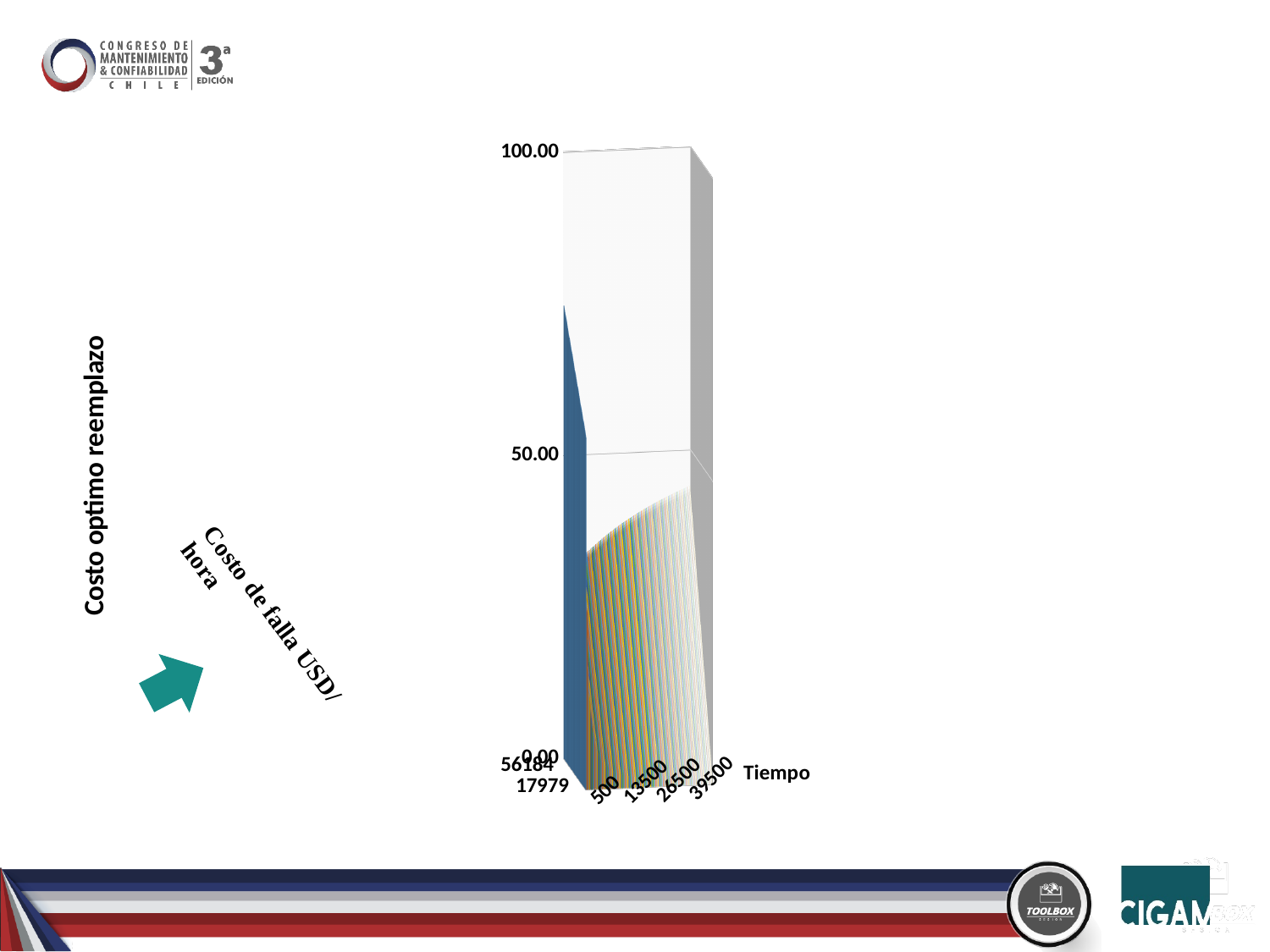
What is the lowest tick label shown on the Tiempo axis of the chart? 500 What is the title of the horizontal axis of the chart? Tiempo Which two values are labelled on the depth axis of the chart? 17979 and 56184 What is the highest value labelled on the vertical axis of the chart? 100.00 What is the middle tick label on the vertical axis of the chart? 50.00 What is the highest tick label shown on the Tiempo axis of the chart? 39500 How many tick labels are shown on the Tiempo axis of the chart? 4 What kind of chart is shown on the slide? 3D surface chart